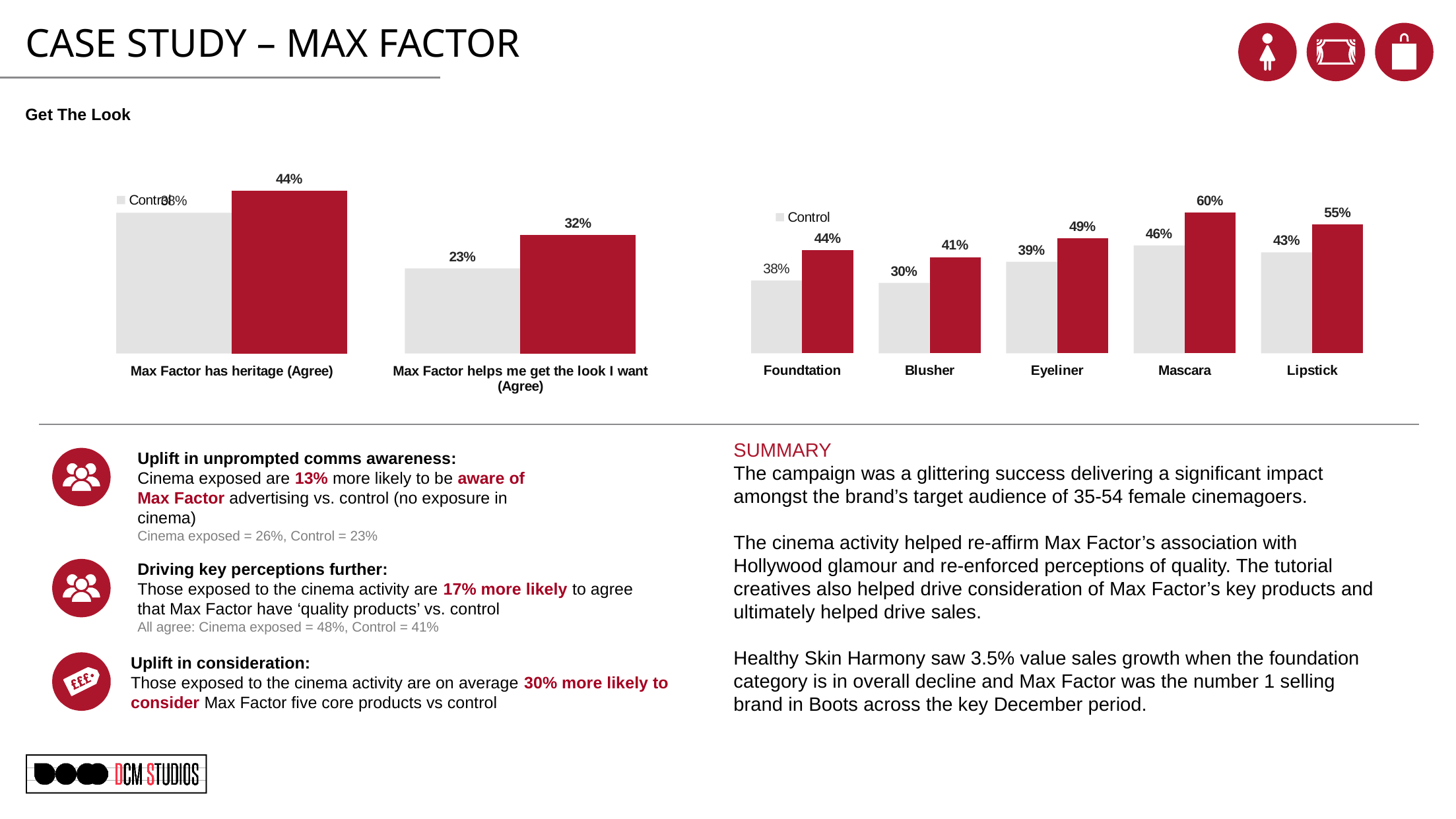
In the right-hand chart, which is larger: the red bar for Foundtation or the red bar for Lipstick? Lipstick In the right-hand chart, what value does the red bar show for Mascara? 60% In the left-hand chart, what is the difference between the red bar and the Control bar for 'Max Factor helps me get the look I want (Agree)'? 9% In the right-hand chart, what is the Control value for Lipstick? 43% What type of chart is the right-hand chart? Bar chart In the left-hand chart, what is the Control value for 'Max Factor helps me get the look I want (Agree)'? 23% How many product categories are shown on the x axis of the right-hand chart? 5 In the left-hand chart, what value does the red bar show for 'Max Factor has heritage (Agree)'? 44% In the right-hand chart, which product has the highest red-bar value? Mascara In the right-hand chart, which product has the lowest Control value? Blusher In the right-hand chart, what is the Control value for Blusher? 30% In the right-hand chart, what is the difference between the red bar and the Control bar for Eyeliner? 10%